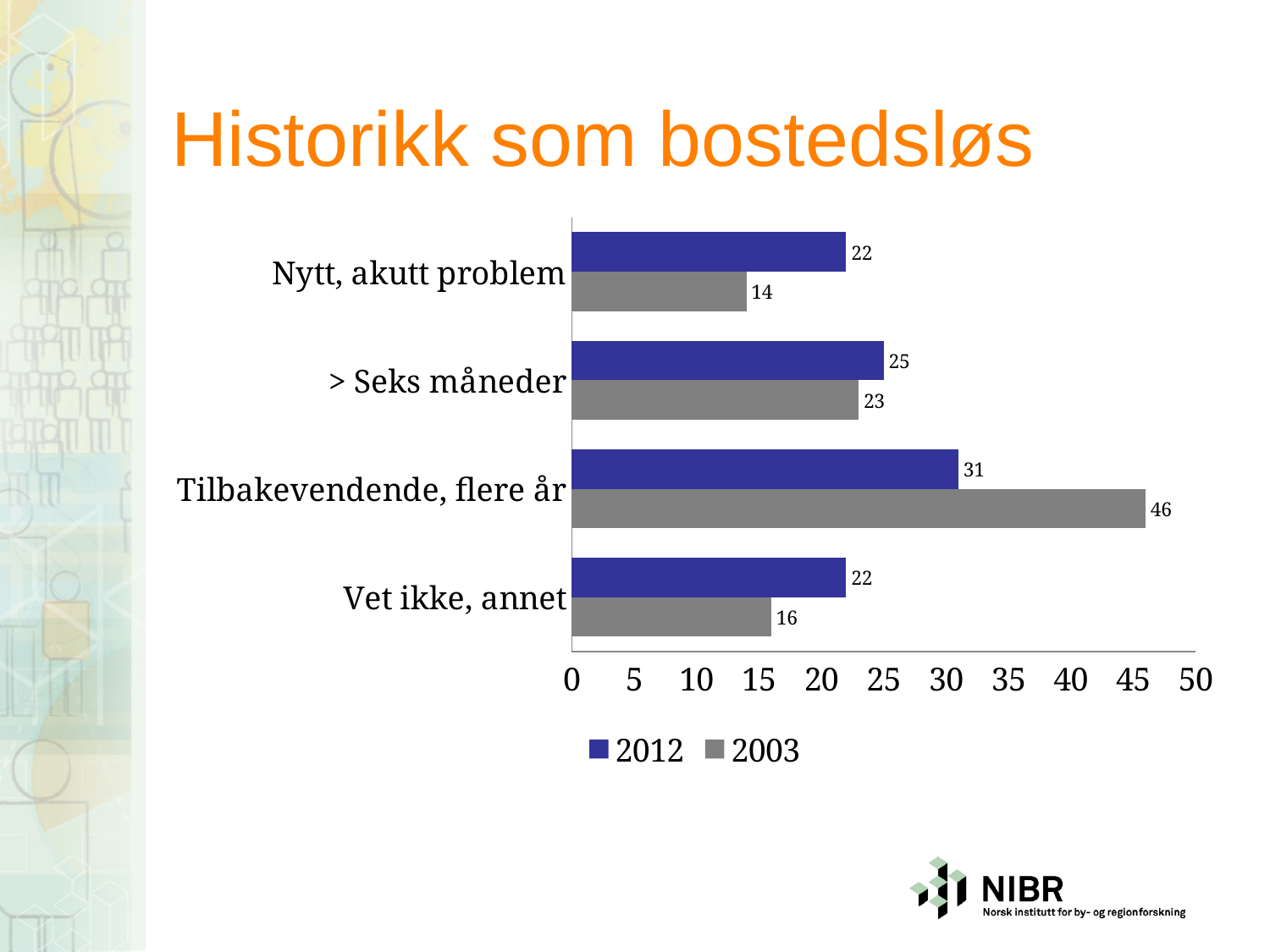
What is the value for 2012 in the "Nytt, akutt problem" category? 22 What kind of chart is shown on the slide? Bar chart How many series does the legend list? 2 What is the value for 2003 in the "> Seks måneder" category? 23 How many categories are shown on the chart? 4 What is the difference between the 2003 and 2012 values for "Tilbakevendende, flere år"? 15 Which category has the highest value for the 2003 series? Tilbakevendende, flere år Which is larger for "Vet ikke, annet": the 2012 value or the 2003 value? 2012 Which category has the lowest value for the 2003 series? Nytt, akutt problem What is the title of the slide? Historikk som bostedsløs Is the 2003 value for "Tilbakevendende, flere år" greater or less than 40? greater What is the value for 2003 in the "Tilbakevendende, flere år" category? 46